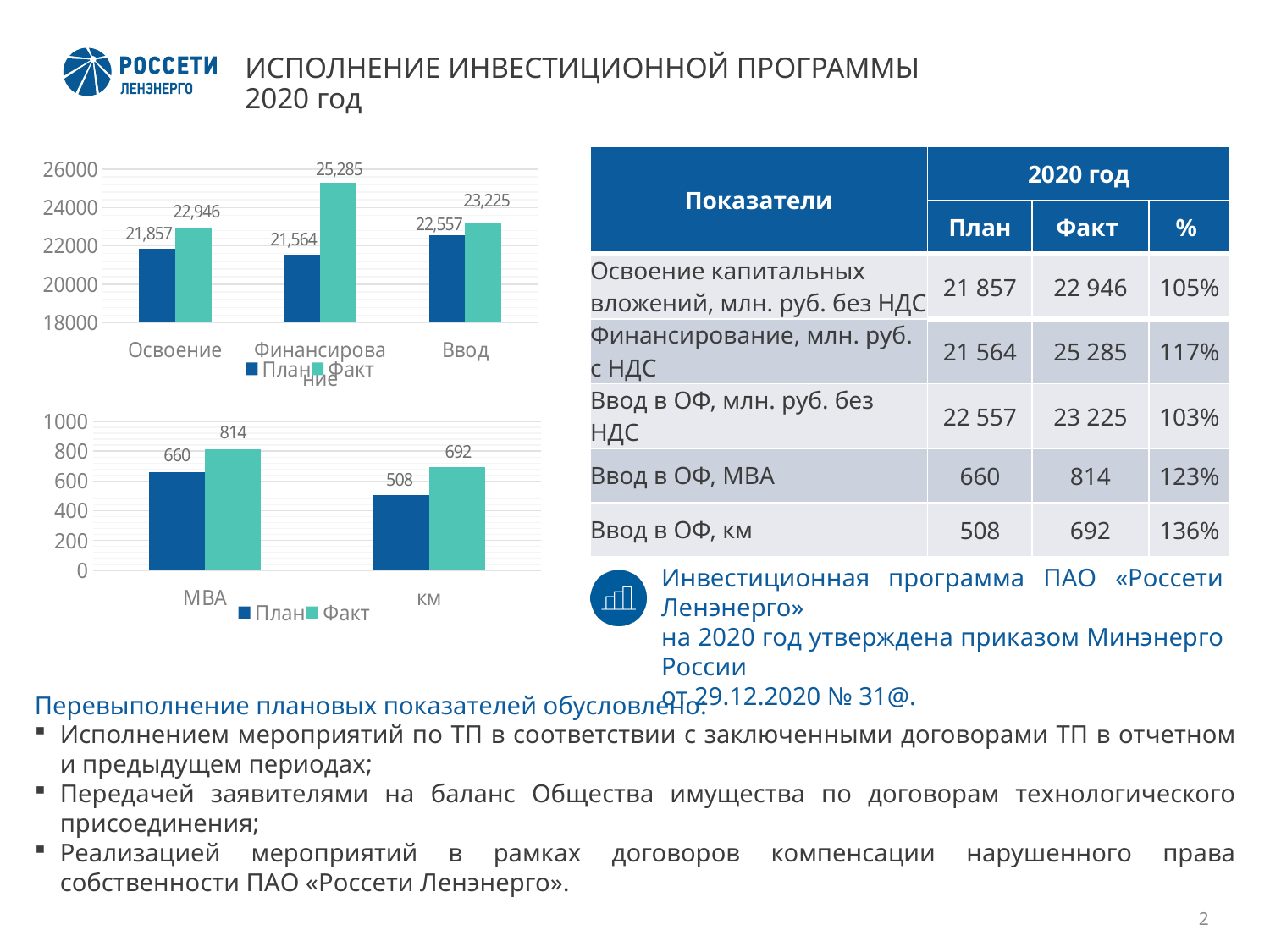
How many series does the legend of the bottom chart on the left list? 2 In the top chart on the left, which category has the highest Факт value? Финансирование In the bottom chart on the left, which is larger: the План value for МВА or the План value for км? МВА In the top chart on the left, which category has the lowest План value? Финансирование In the bottom chart on the left, what is the План value for км? 508 In the top chart on the left, what is the Факт value for Финансирование? 25,285 What type of chart is the top chart on the left? Bar chart In the top chart on the left, what is the difference between the Факт and План values for Ввод? 668 In the top chart on the left, what is the План value for Освоение? 21,857 In the top chart on the left, is the План value for Ввод greater or less than 22000? greater In the bottom chart on the left, what is the Факт value for МВА? 814 In the bottom chart on the left, what is the difference between the Факт and План values for км? 184